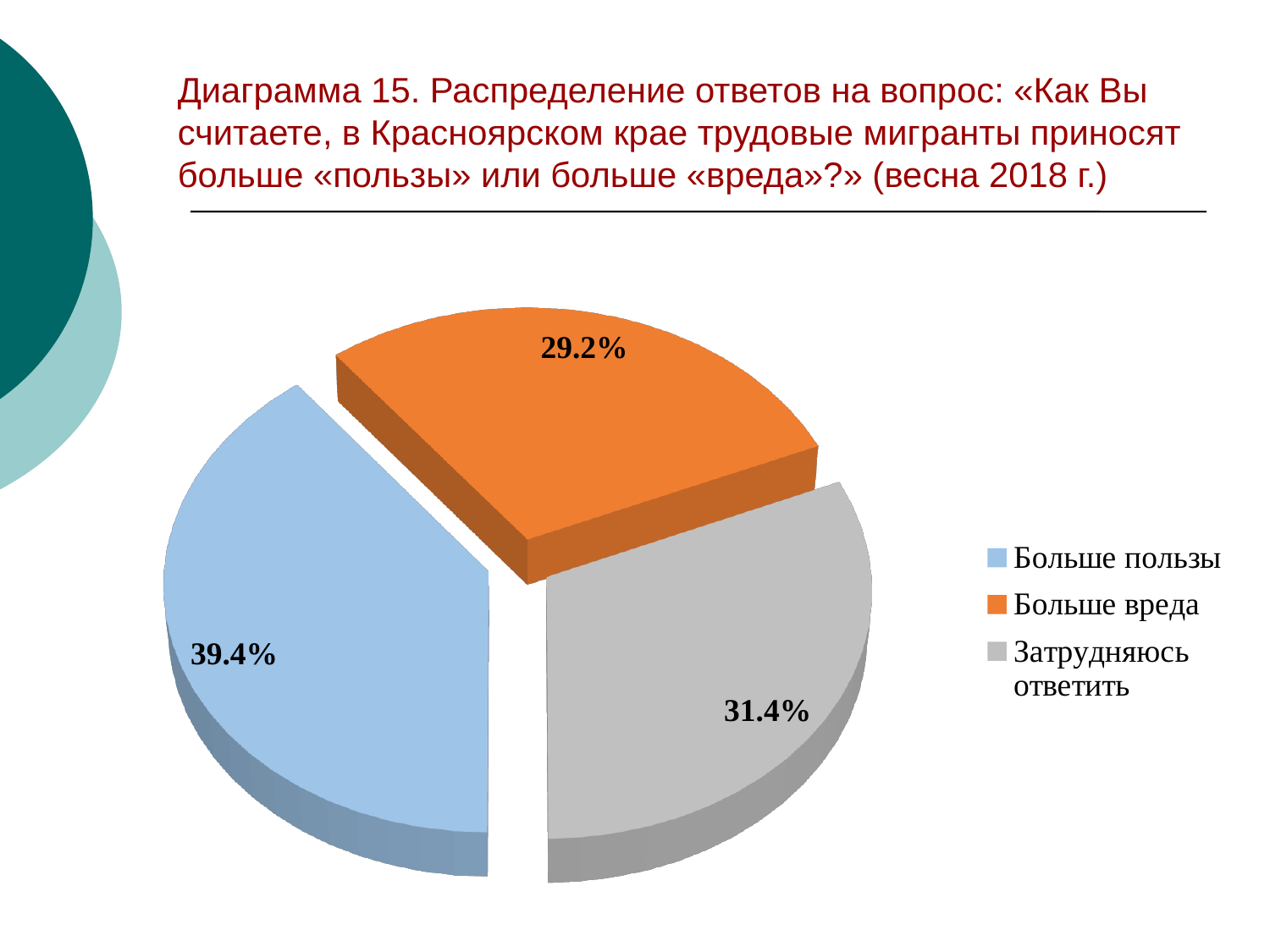
Which answer option has the largest share of the pie? Больше пользы What share of respondents answered «Затрудняюсь ответить»? 31.4% Which is larger: the share for «Больше вреда» or the share for «Затрудняюсь ответить»? Затрудняюсь ответить What colour is the slice for «Больше вреда»? Orange Which answer option is shown in grey in the legend? Затрудняюсь ответить What is the difference in percentage points between «Затрудняюсь ответить» and «Больше вреда»? 2.2 What share of respondents answered «Больше пользы»? 39.4% What is the difference in percentage points between «Больше пользы» and «Больше вреда»? 10.2 What share of respondents answered «Больше вреда»? 29.2% What kind of chart is shown on the slide? Pie chart Which answer option has the smallest share of the pie? Больше вреда How many slices does the pie chart have? 3